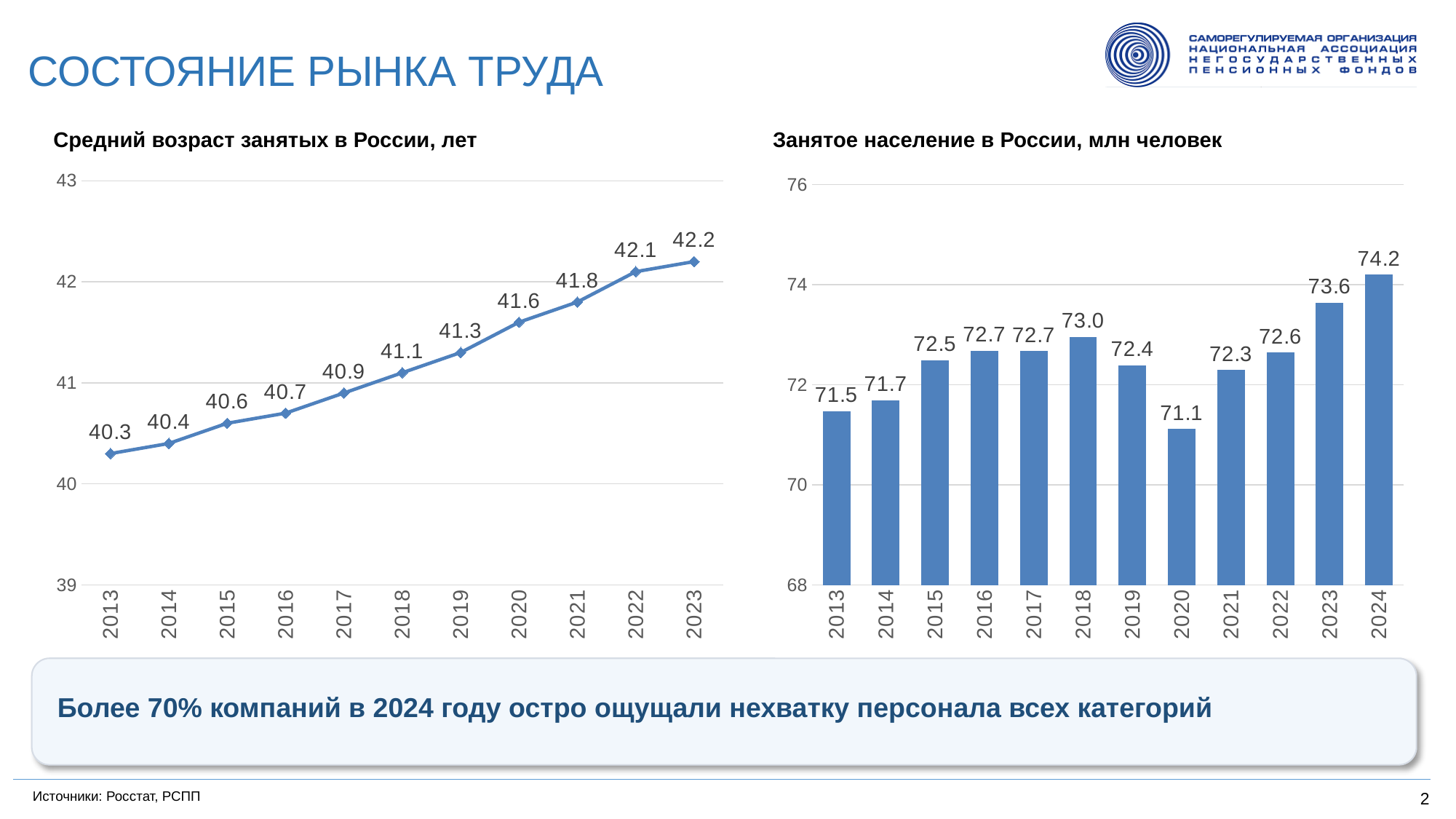
How many bars are in the chart 'Занятое население в России, млн человек'? 12 In the chart 'Занятое население в России, млн человек', which is larger: the value for 2018 or the value for 2021? 2018 In the chart 'Занятое население в России, млн человек', which year has the highest value? 2024 In the chart 'Средний возраст занятых в России, лет', what is the value for 2019? 41.3 In the chart 'Средний возраст занятых в России, лет', do the values rise or fall from 2013 to 2023? Rise In the chart 'Занятое население в России, млн человек', what is the difference between the values for 2024 and 2023? 0.6 How many data points are plotted in the chart 'Средний возраст занятых в России, лет'? 11 What type of chart is 'Занятое население в России, млн человек'? Bar chart In the chart 'Занятое население в России, млн человек', which year has the lowest value? 2020 In the chart 'Средний возраст занятых в России, лет', what is the difference between the values for 2023 and 2013? 1.9 In the chart 'Средний возраст занятых в России, лет', which year has the lowest value? 2013 In the chart 'Занятое население в России, млн человек', what is the value for 2020? 71.1